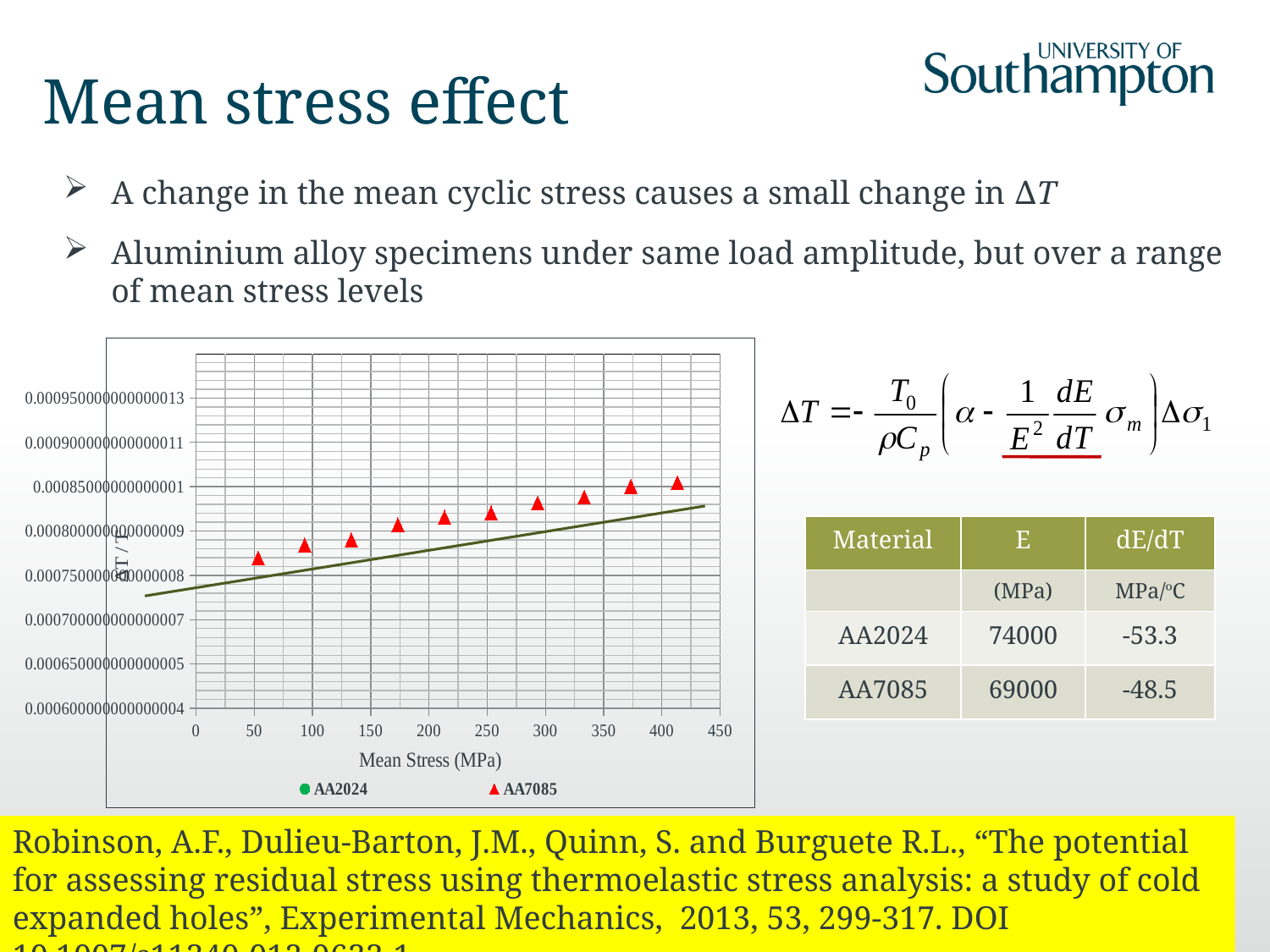
Are all the plotted AA7085 values greater or less than 0.0007? greater Does the AA7085 point with the highest ΔT/T occur at the lowest or the highest mean stress plotted? highest Is the AA7085 value at about 300 MPa mean stress greater or less than 0.0008? greater Do the plotted AA7085 values rise or fall as mean stress increases? rise Is the AA7085 value at about 50 MPa mean stress greater or less than 0.0008? less What are the two series named in the chart legend? AA2024 and AA7085 Does the AA7085 point with the lowest ΔT/T occur at the lowest or the highest mean stress plotted? lowest What is the title of the x axis of the chart? Mean Stress (MPa) How many series does the chart legend list? 2 What kind of chart is shown on the slide? scatter chart Is the AA7085 value at about 400 MPa mean stress larger or smaller than the value at about 50 MPa? larger How many AA7085 data points (red triangles) are plotted on the chart? 10